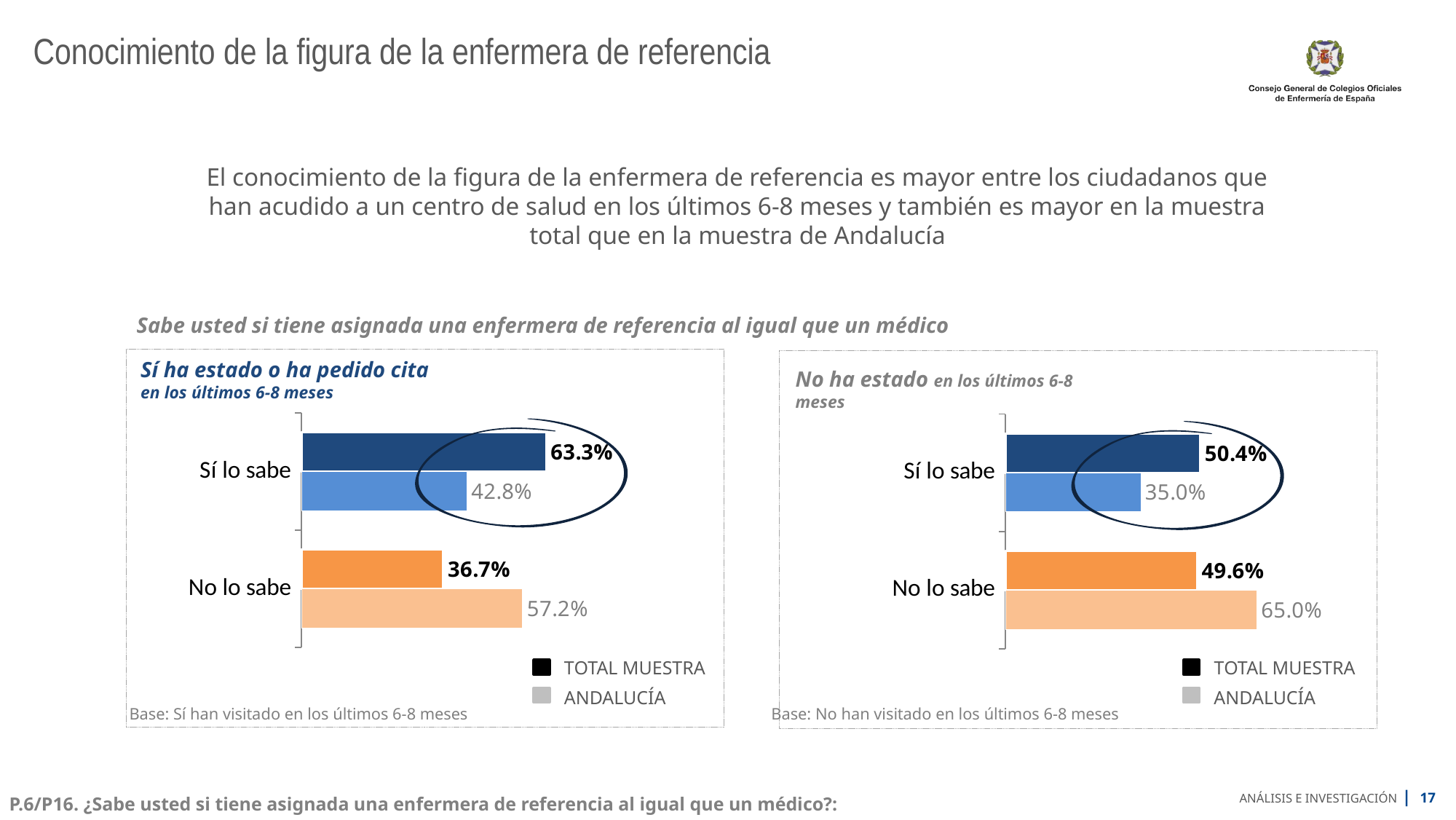
In the left chart (Sí ha estado o ha pedido cita), what is the ANDALUCÍA value for 'No lo sabe'? 57.2% How many categories are shown in the right chart (No ha estado)? 2 What kind of chart is the left chart (Sí ha estado o ha pedido cita)? Bar chart In the left chart (Sí ha estado o ha pedido cita), what is the TOTAL MUESTRA value for 'Sí lo sabe'? 63.3% In the left chart (Sí ha estado o ha pedido cita), which series has the higher value for 'No lo sabe'? ANDALUCÍA What are the two legend entries in the right chart (No ha estado)? TOTAL MUESTRA and ANDALUCÍA In the right chart (No ha estado), what is the ANDALUCÍA value for 'No lo sabe'? 65.0% In the right chart (No ha estado), what is the difference between the ANDALUCÍA and TOTAL MUESTRA values for 'No lo sabe'? 15.4% How many series does the legend of the left chart list? 2 In the right chart (No ha estado), which is larger for 'Sí lo sabe': TOTAL MUESTRA or ANDALUCÍA? TOTAL MUESTRA In the left chart (Sí ha estado o ha pedido cita), what is the difference between the TOTAL MUESTRA and ANDALUCÍA values for 'Sí lo sabe'? 20.5% In the right chart (No ha estado), what is the TOTAL MUESTRA value for 'Sí lo sabe'? 50.4%